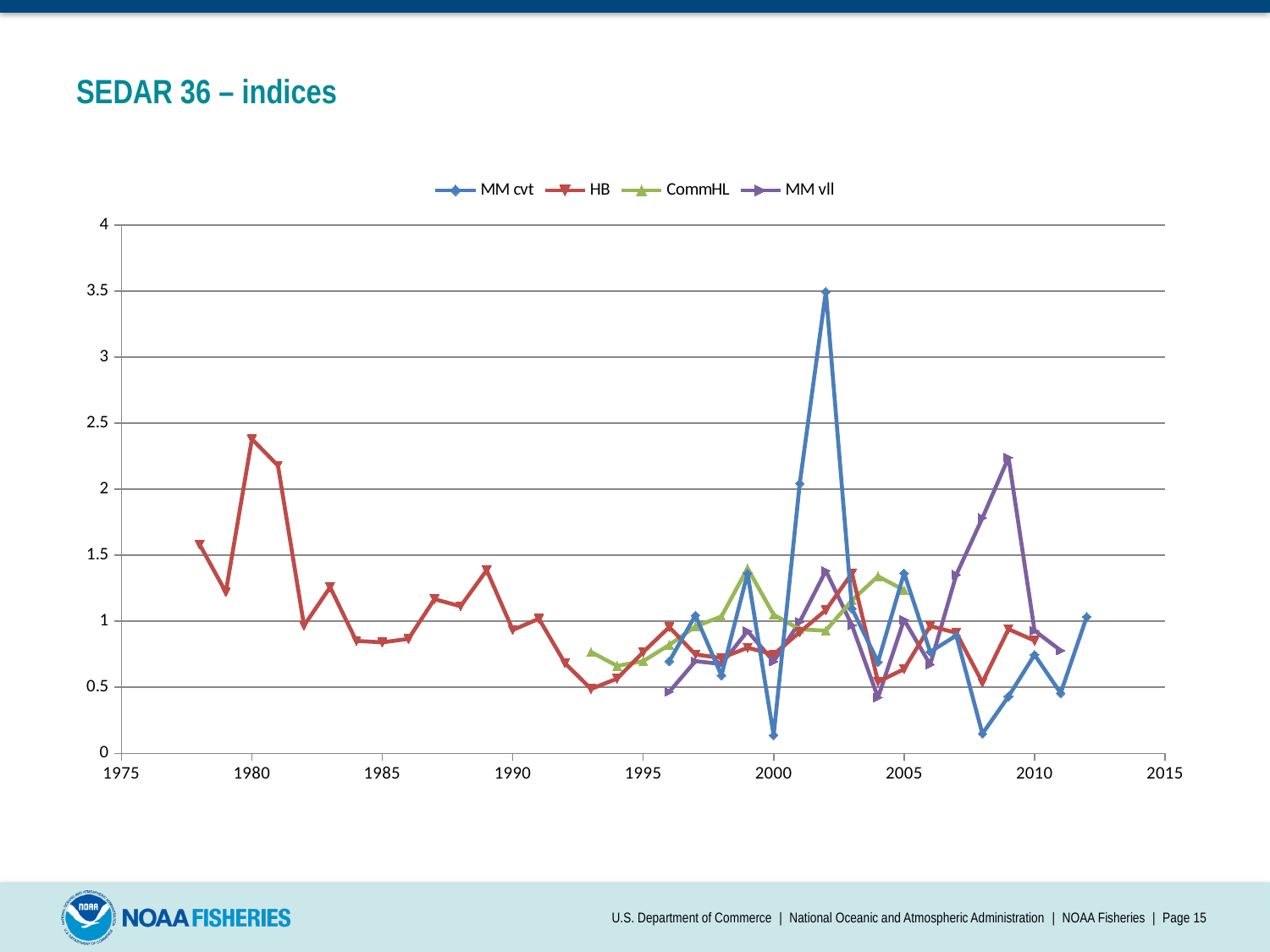
Which series begins earliest on the x axis? HB Is the value of the HB series in 1993 greater or less than 1? less How many series does the legend list? 4 Is the peak value of the MM cvt series (around 2002) greater or less than 3? greater Does the HB series rise or fall between 1981 and 1982? fall What kind of chart is shown on the slide? line chart Is the value of the MM cvt series in 2000 greater or less than 0.5? less Which is larger: the peak of the MM cvt series or the peak of the HB series? MM cvt What is the title of the slide? SEDAR 36 – indices Which series reaches the highest value anywhere on the chart? MM cvt